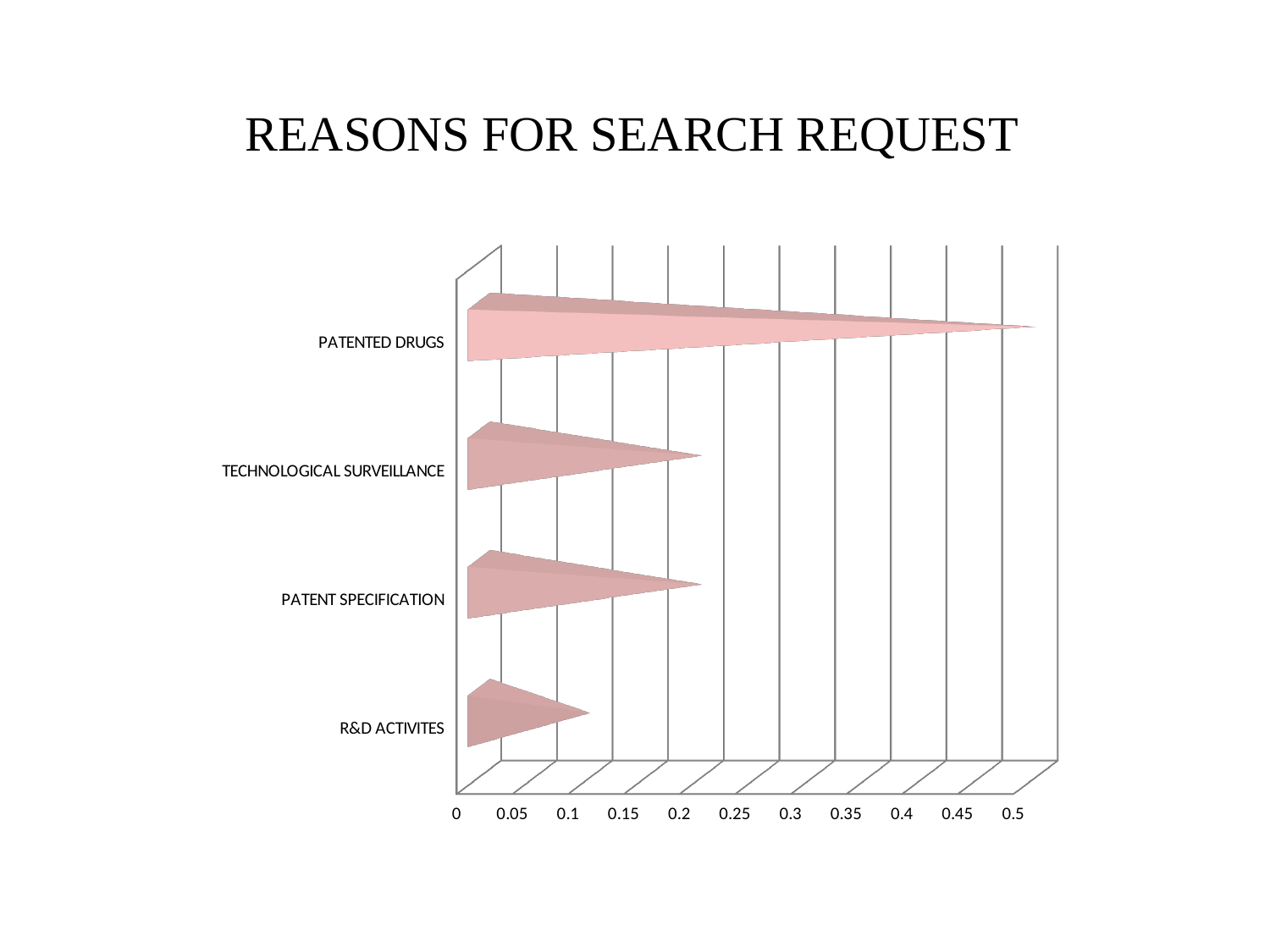
Which is larger, the value for PATENTED DRUGS or the value for R&D ACTIVITES? PATENTED DRUGS Which category has the highest value? PATENTED DRUGS What is the title of the chart? REASONS FOR SEARCH REQUEST Is the value for R&D ACTIVITES greater or less than 0.15? less Is the value for PATENT SPECIFICATION greater or less than 0.3? less Which is larger, the value for PATENTED DRUGS or the value for TECHNOLOGICAL SURVEILLANCE? PATENTED DRUGS Which category has the lowest value? R&D ACTIVITES Is the value for PATENTED DRUGS greater or less than 0.4? greater How many categories are plotted in the chart? 4 What is the highest value shown on the horizontal axis? 0.5 What kind of chart is shown on the slide? bar chart